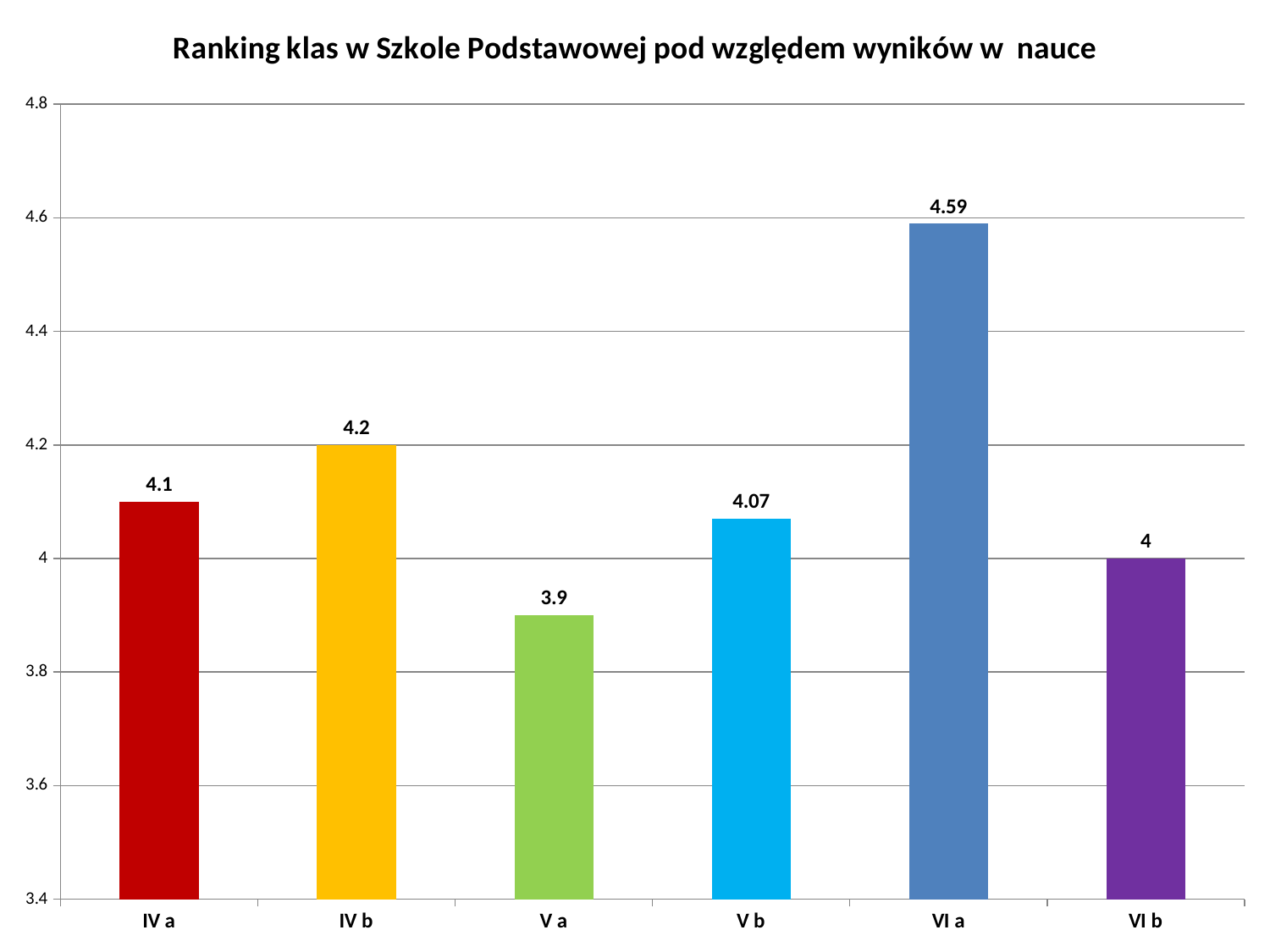
How many classes are shown on the chart? 6 What is the difference between the values for VI a and V a? 0.69 What is the title of the chart? Ranking klas w Szkole Podstawowej pod względem wyników w nauce Which is larger, the value for IV b or the value for VI b? IV b What is the value for class VI a? 4.59 What kind of chart is this? bar chart What is the difference between the values for IV b and IV a? 0.1 Which class has the highest value? VI a Which class has the lowest value? V a What is the value for class IV a? 4.1 Is the value for V a greater or less than 4? less What is the value for class V b? 4.07